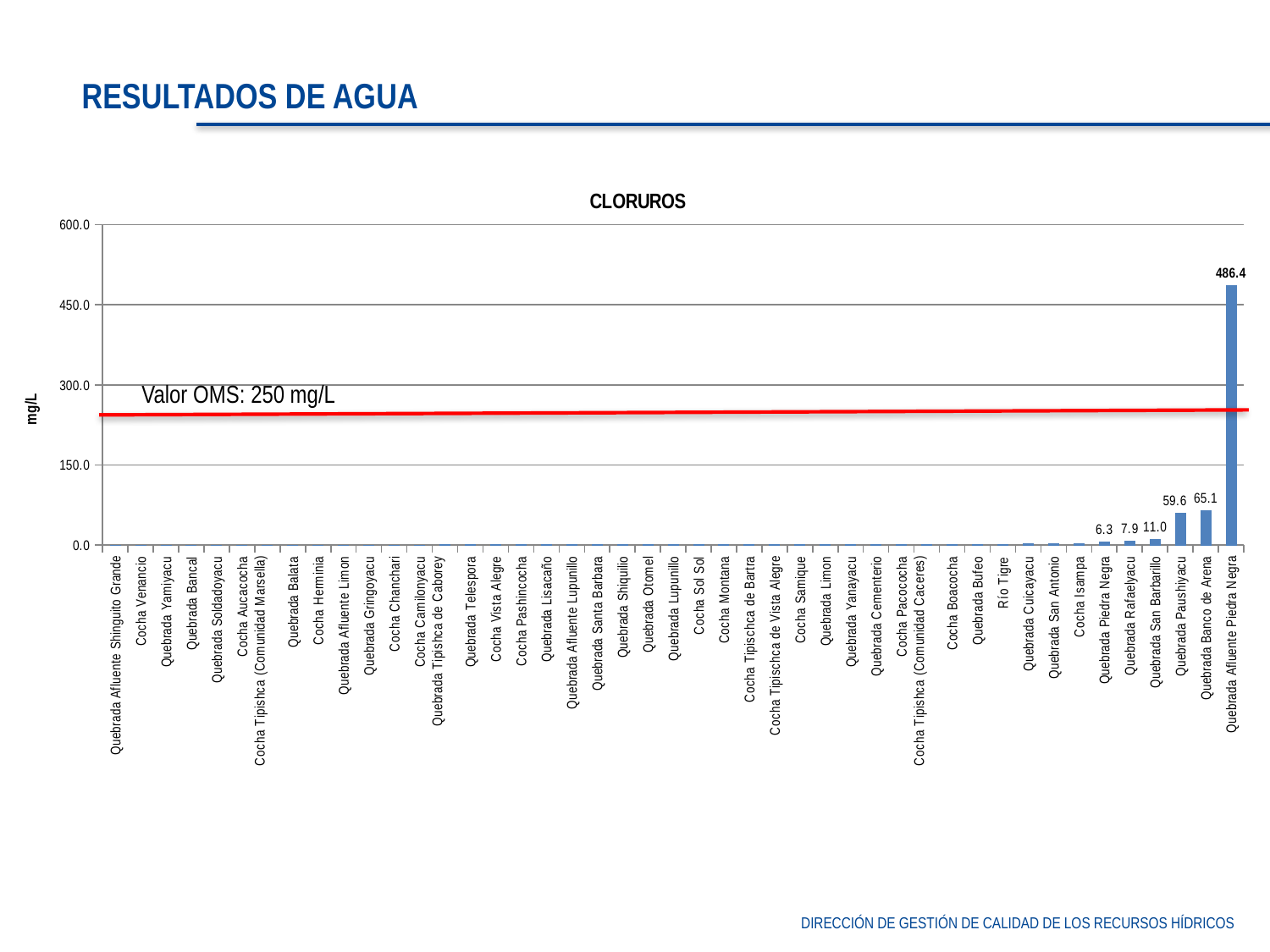
What is the value shown for Quebrada Piedra Negra? 6.3 Which category has the highest chloride value? Quebrada Afluente Piedra Negra What is the difference between the values for Quebrada Afluente Piedra Negra and Quebrada Banco de Arena? 421.3 What is the OMS reference value marked by the red line on the chart? 250 mg/L What kind of chart is shown on the slide? bar chart What is the value shown for Quebrada Banco de Arena? 65.1 What is the difference between the values for Quebrada Banco de Arena and Quebrada Paushiyacu? 5.5 What is the value shown for Quebrada San Barbarillo? 11.0 Which is larger, the value for Quebrada Rafaelyacu or the value for Quebrada San Barbarillo? Quebrada San Barbarillo Is the value for Quebrada Afluente Piedra Negra greater or less than 450? greater What is the chloride value for Quebrada Afluente Piedra Negra? 486.4 What is the value shown for Quebrada Paushiyacu? 59.6